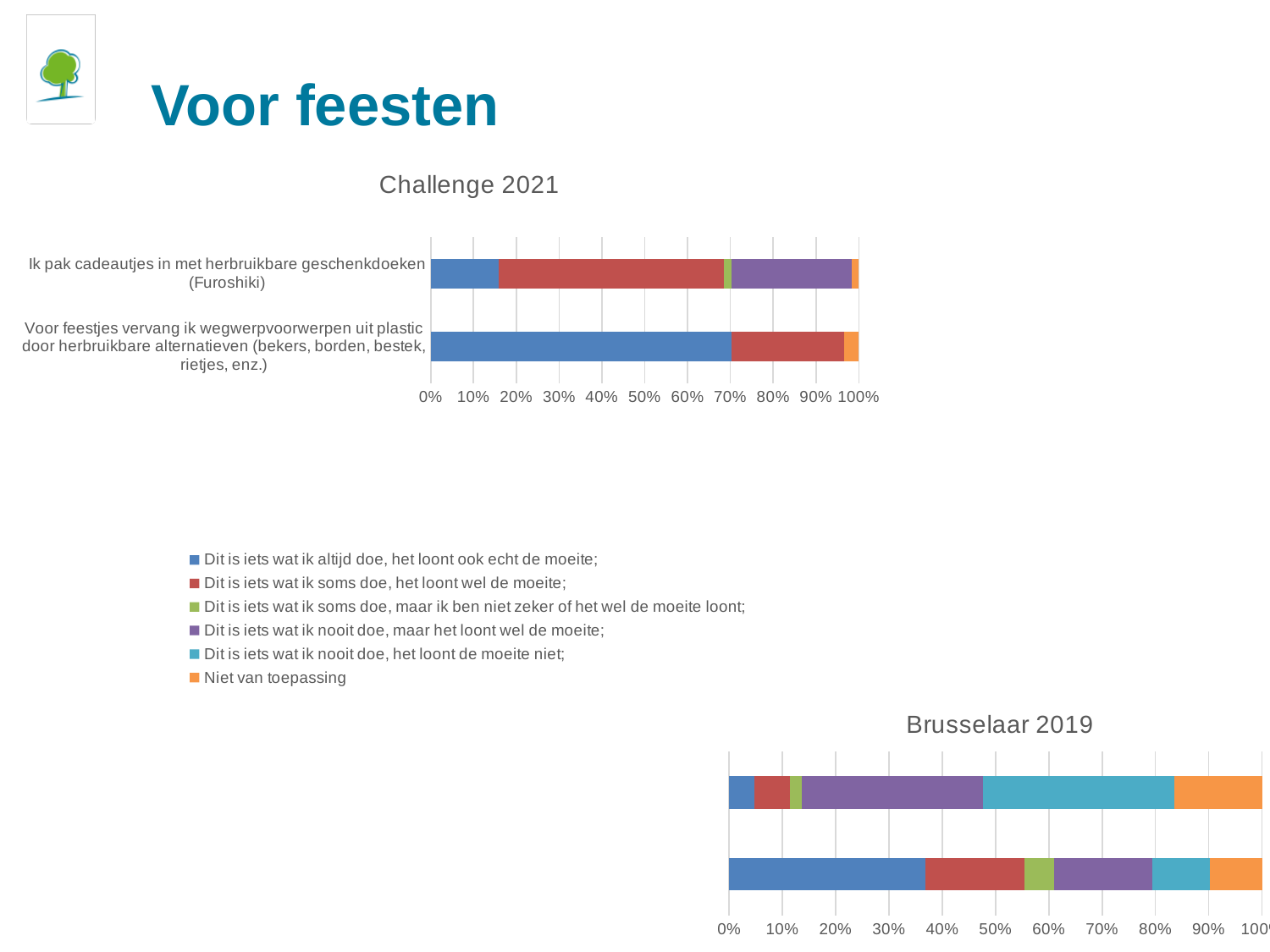
What kind of chart is the Challenge 2021 chart? Stacked bar chart In the Challenge 2021 chart, is the blue 'altijd doe' share for 'Ik pak cadeautjes in met herbruikbare geschenkdoeken (Furoshiki)' greater or less than 20%? less How many series does the legend list? 6 In the Challenge 2021 chart, which category has the larger blue 'Dit is iets wat ik altijd doe' share? Voor feestjes vervang ik wegwerpvoorwerpen uit plastic door herbruikbare alternatieven (bekers, borden, bestek, rietjes, enz.) In the Brusselaar 2019 chart, which bar has the larger teal 'nooit doe, het loont de moeite niet' segment, the top or the bottom bar? Top bar In the Challenge 2021 chart, which category has the larger purple 'nooit doe, maar het loont wel de moeite' share? Ik pak cadeautjes in met herbruikbare geschenkdoeken (Furoshiki) How many categories are shown in the Challenge 2021 chart? 2 What is the title of the chart at the bottom right of the slide? Brusselaar 2019 In the Challenge 2021 chart, is the blue 'altijd doe' share for 'Voor feestjes vervang ik wegwerpvoorwerpen uit plastic door herbruikbare alternatieven' greater or less than 60%? greater In the Brusselaar 2019 chart, is the blue segment of the top bar greater or less than 10%? less Which colour represents 'Niet van toepassing' in the legend? Orange